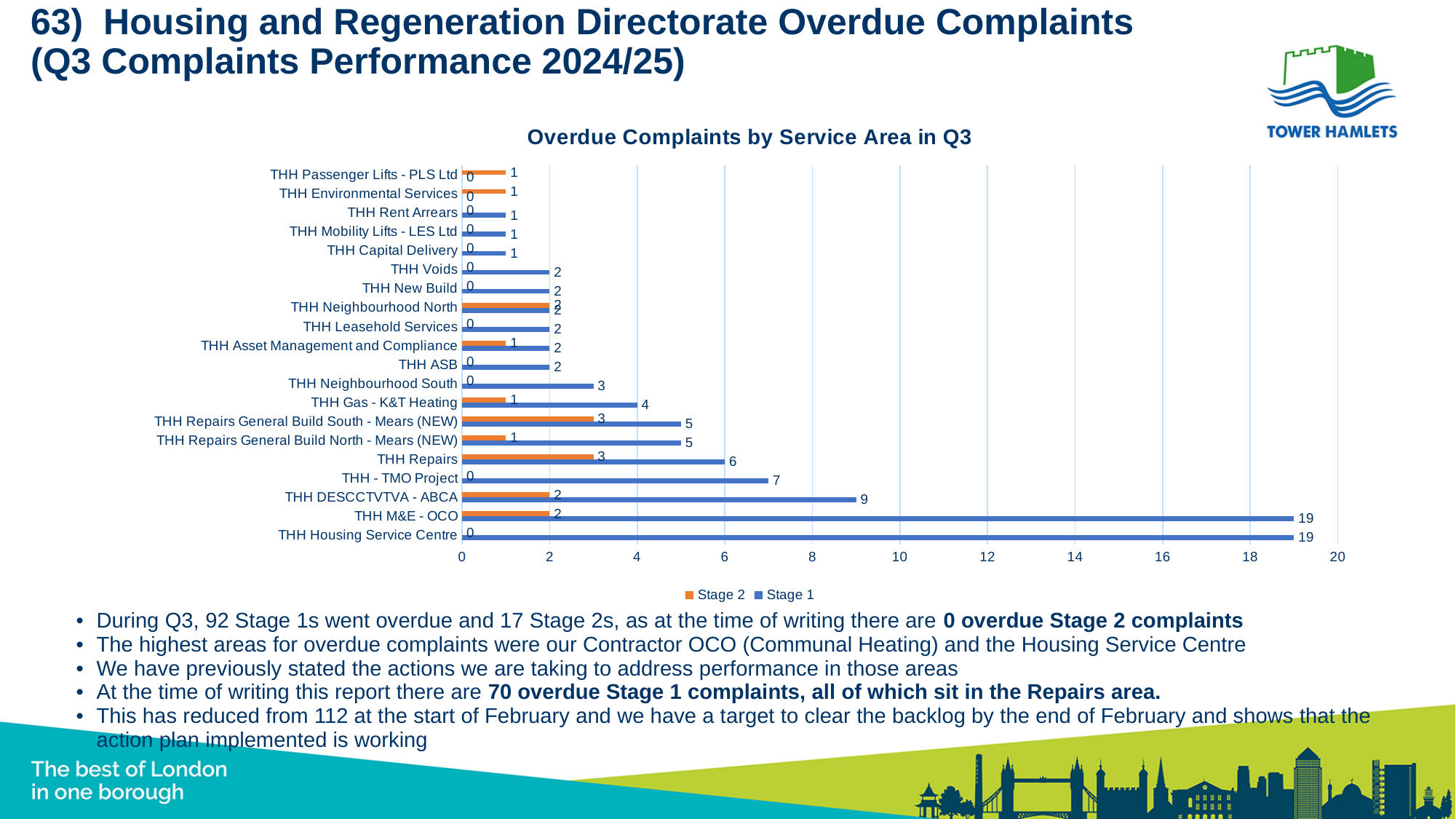
What is the Stage 2 value for THH Neighbourhood North? 2 Which has a larger Stage 1 value, THH Repairs or THH Gas - K&T Heating? THH Repairs What is the Stage 1 value for THH - TMO Project? 7 What type of chart is shown on the slide? Bar chart What is the Stage 2 value for THH Repairs? 3 What is the difference between the Stage 1 values for THH M&E - OCO and THH DESCCTVTVA - ABCA? 10 What is the Stage 1 value for THH M&E - OCO? 19 What is the title of the chart? Overdue Complaints by Service Area in Q3 How many service areas are shown on the chart? 20 How many series does the legend list? 2 What is the Stage 1 value for THH DESCCTVTVA - ABCA? 9 What is the difference between the Stage 1 and Stage 2 values for THH Repairs General Build South - Mears (NEW)? 2